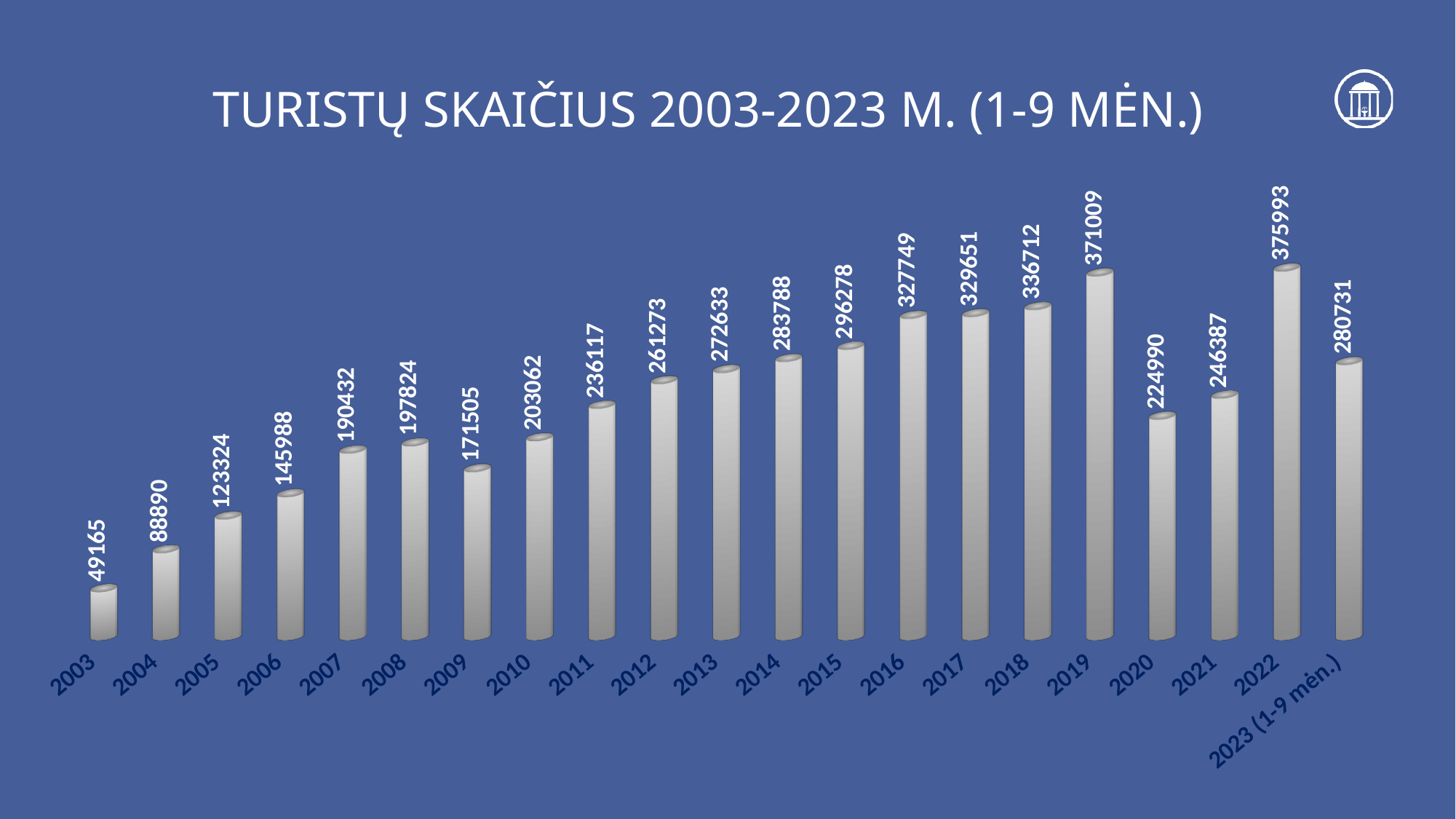
What kind of chart is this? bar chart What value is shown for 2019? 371009 By how much did the value drop from 2019 to 2020? 146019 What is the difference between the values for 2022 and 2019? 4984 How many years (categories) are shown on the chart? 21 What is the title of the chart? TURISTŲ SKAIČIUS 2003-2023 M. (1-9 MĖN.) What is the number of tourists shown for 2003? 49165 Which is larger, the value for 2009 or the value for 2008? 2008 What is the value for 2023 (1-9 mėn.)? 280731 Which year has the lowest value? 2003 Do the values generally rise or fall from 2003 to 2019? rise Which year has the highest value? 2022